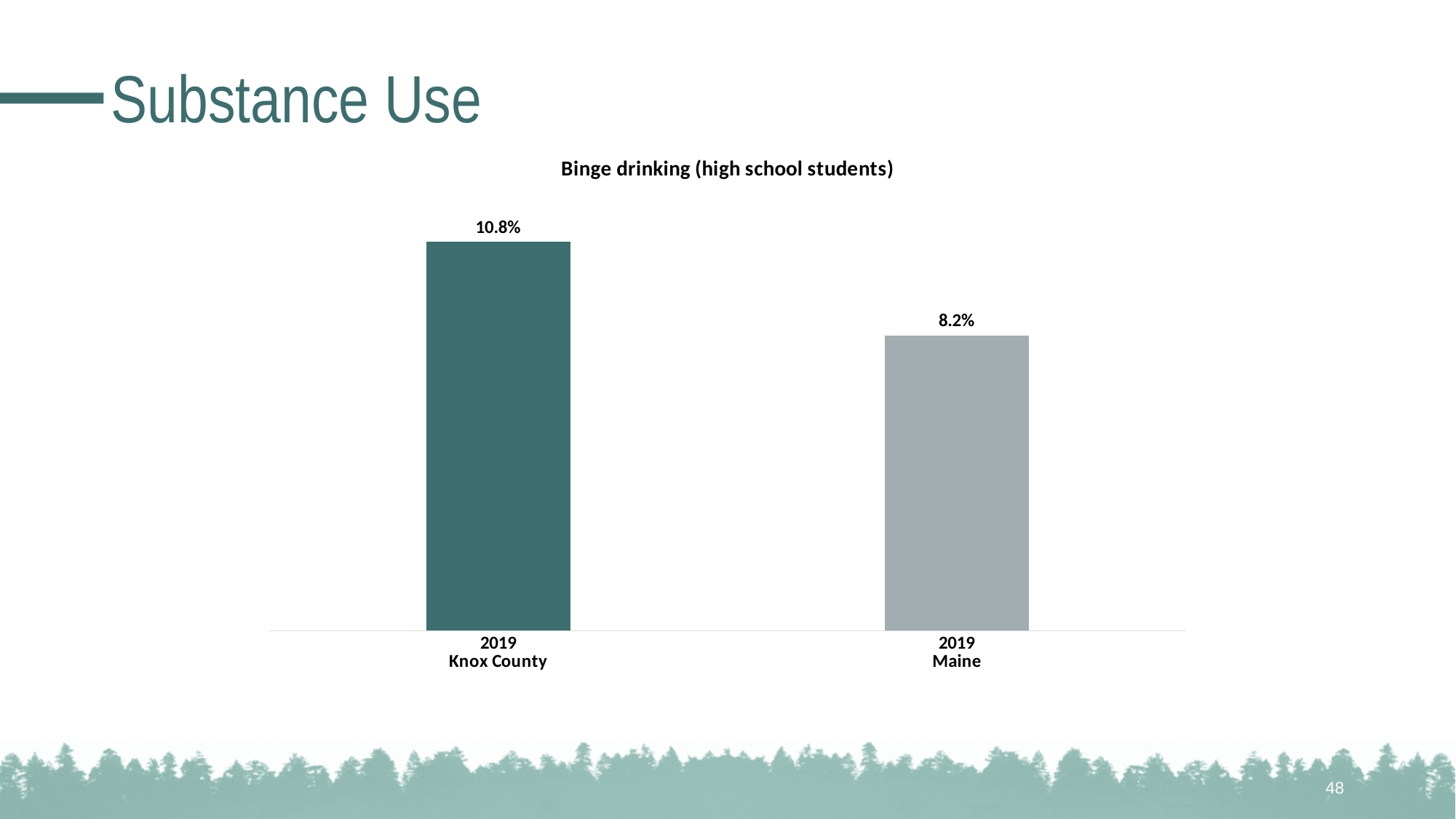
What year do both bars in the chart refer to? 2019 Which category has the lowest binge drinking rate? 2019 Maine Which is larger, the binge drinking rate for Knox County or for Maine? Knox County What kind of chart is shown on the slide? Bar chart What is the difference between the Knox County and Maine binge drinking rates? 2.6% What is the binge drinking rate for 2019 Knox County? 10.8% How many bars are shown in the chart? 2 What is the title of the chart? Binge drinking (high school students) Which category has the highest binge drinking rate? 2019 Knox County What is the binge drinking rate for 2019 Maine? 8.2%